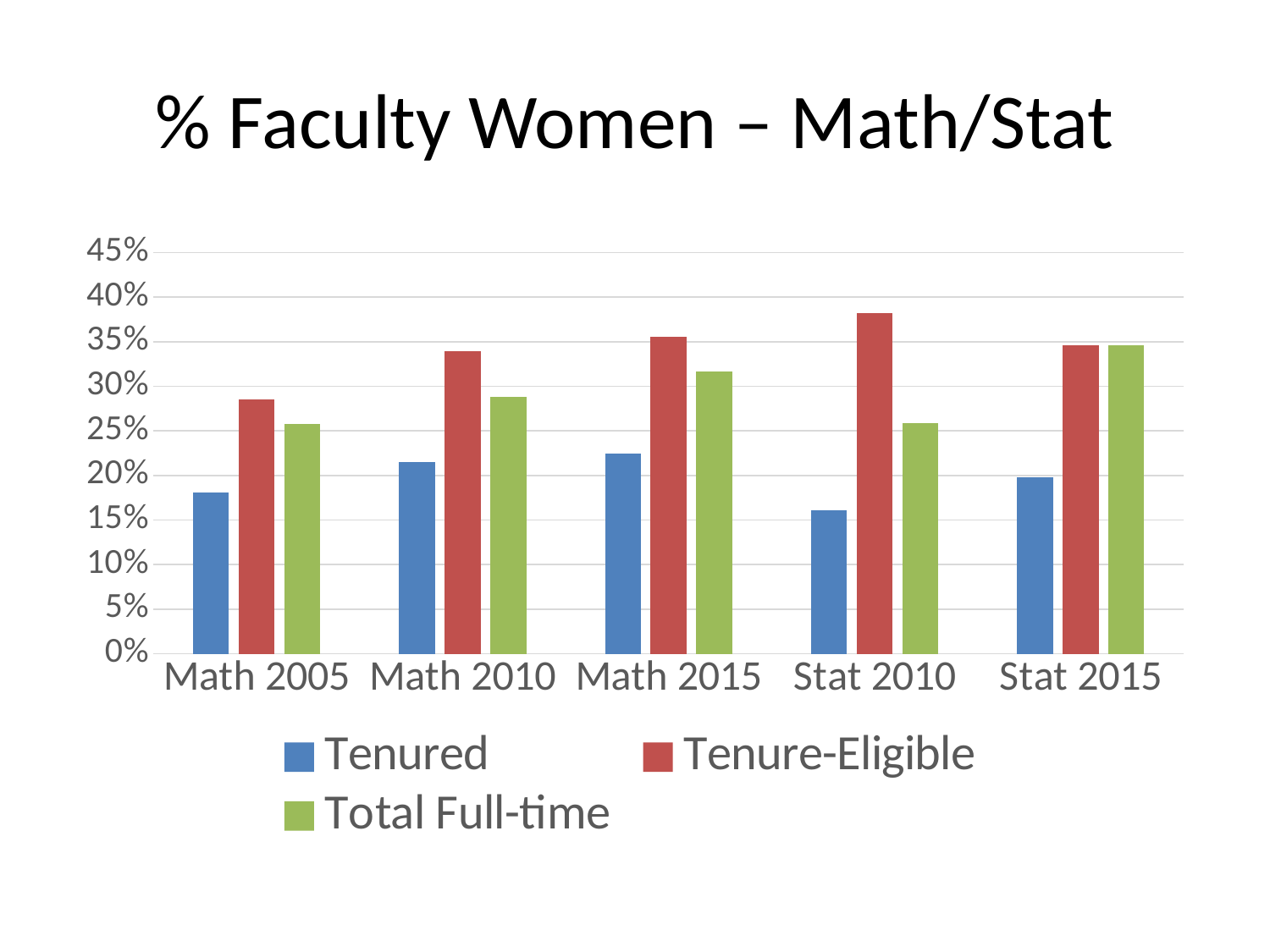
What is the title of the chart? % Faculty Women – Math/Stat Is the Total Full-time value for Math 2015 greater or less than 30%? greater For Math 2010, which is larger: Tenure-Eligible or Total Full-time? Tenure-Eligible How many series does the legend list? 3 Which category has the lowest Tenured value? Stat 2010 Which category has the highest Tenure-Eligible value? Stat 2010 Is the Tenured value for Math 2005 greater or less than 20%? less Does the Tenured value rise or fall from Math 2005 to Math 2015? rise What kind of chart is shown on the slide? bar chart Which category has the highest Total Full-time value? Stat 2015 Is the Tenure-Eligible value for Stat 2010 greater or less than 35%? greater How many categories are shown on the x axis? 5